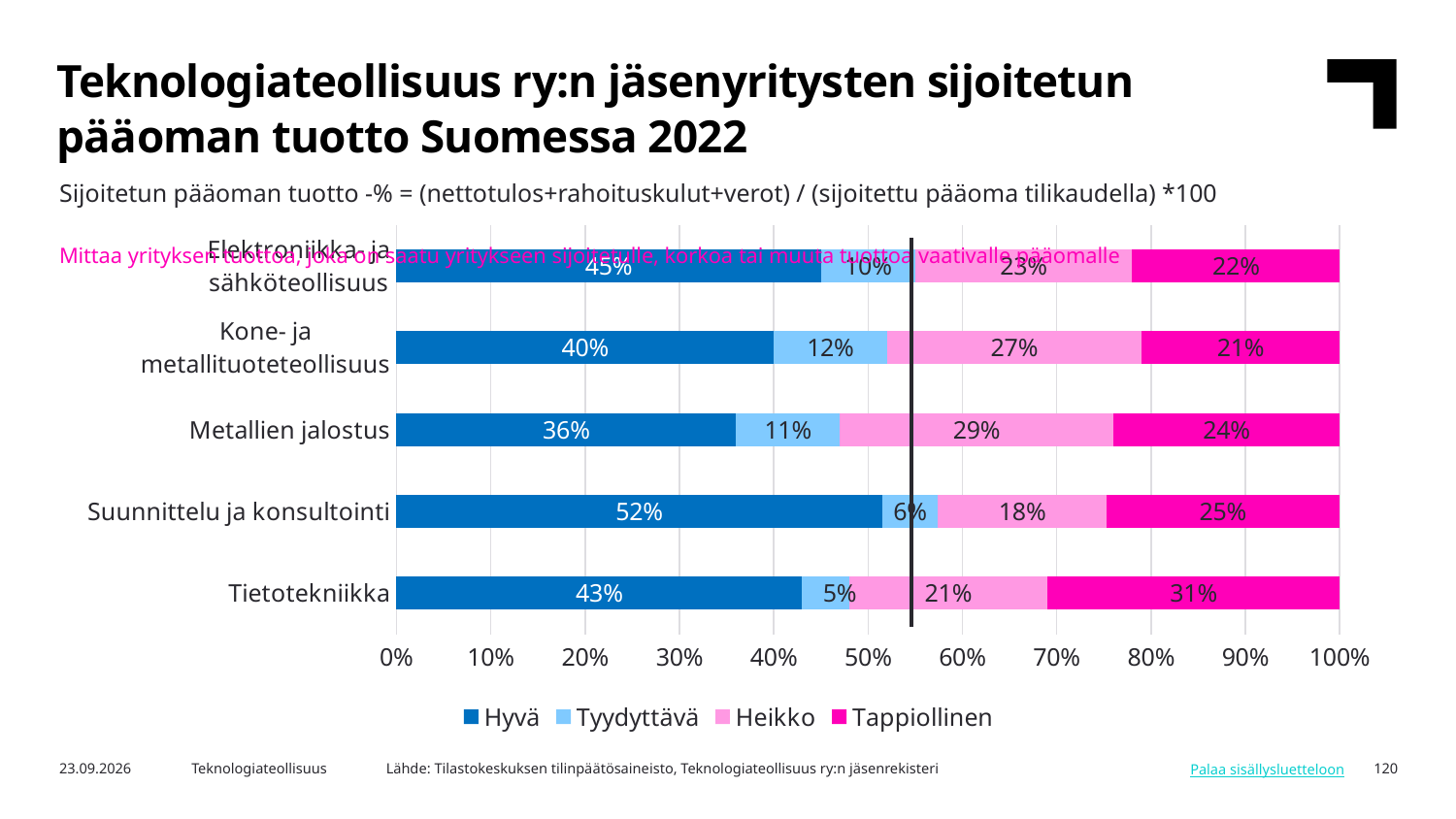
What is the Tappiollinen share for Elektroniikka- ja sähköteollisuus? 22% Which category has the highest Hyvä share? Suunnittelu ja konsultointi What is the Heikko share for Metallien jalostus? 29% What is the Tappiollinen share for Tietotekniikka? 31% What is the difference between the Hyvä share for Suunnittelu ja konsultointi and for Metallien jalostus? 16 percentage points How many series does the legend list? 4 What is the Hyvä share for Suunnittelu ja konsultointi? 52% How many categories are shown on the chart? 5 Which category has the highest Tappiollinen share? Tietotekniikka Which has a larger Heikko share, Kone- ja metallituoteteollisuus or Tietotekniikka? Kone- ja metallituoteteollisuus Which category has the lowest Tyydyttävä share? Tietotekniikka What is the Tyydyttävä share for Kone- ja metallituoteteollisuus? 12%